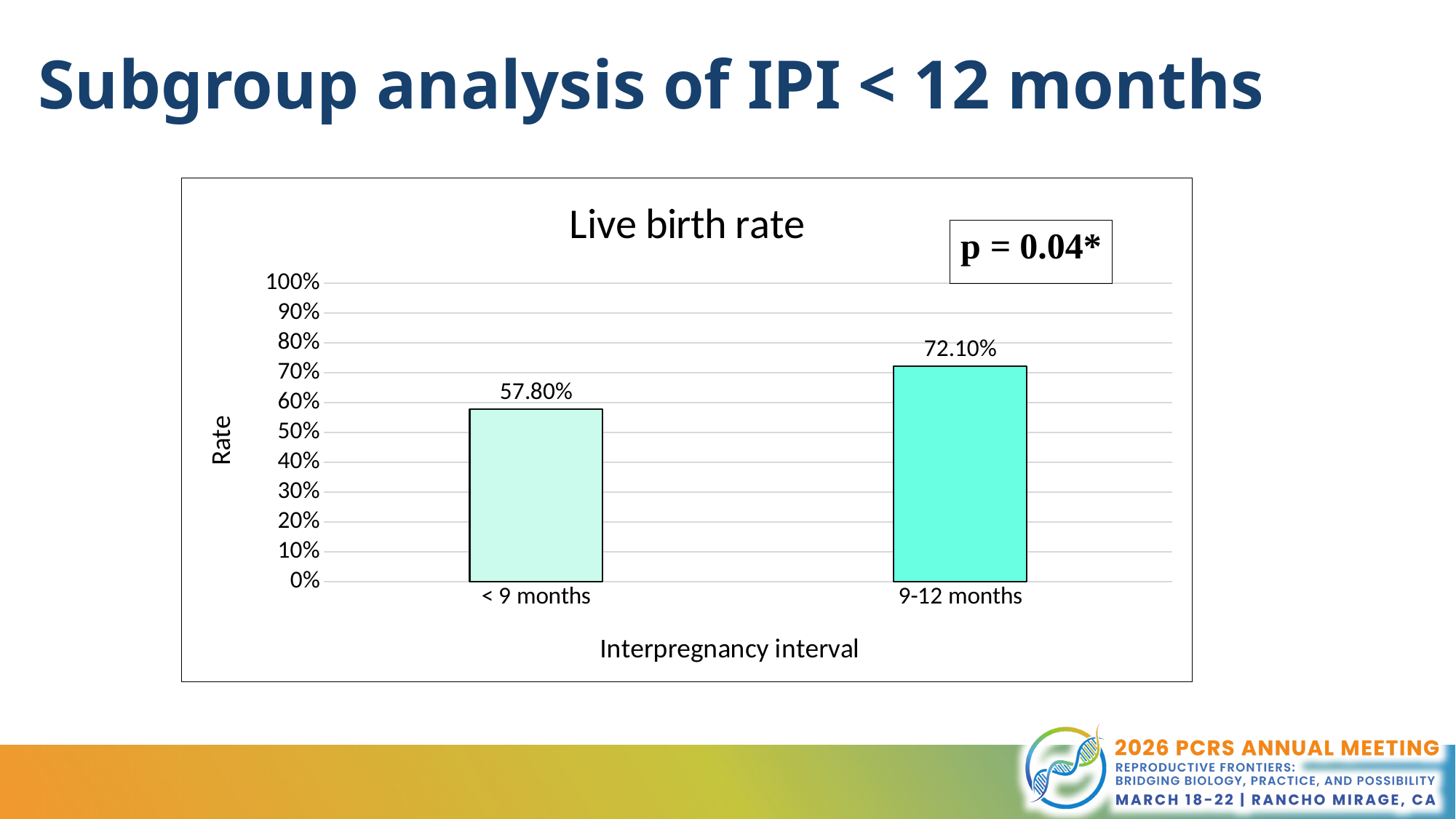
What p-value is shown on the chart? p = 0.04* Which interpregnancy interval has the lower live birth rate? < 9 months Do the live birth rate values rise or fall from < 9 months to 9-12 months? rise Which interpregnancy interval has the higher live birth rate? 9-12 months What is the difference in live birth rate between the 9-12 months and < 9 months groups? 14.30% How many interpregnancy interval categories are shown in the chart? 2 Is the live birth rate for < 9 months greater or less than 60%? less Is the live birth rate for 9-12 months greater or less than 70%? greater What is the live birth rate for the 9-12 months interpregnancy interval? 72.10% What is the title of the chart? Live birth rate What type of chart is used to show the live birth rate? bar chart What is the live birth rate for the < 9 months interpregnancy interval? 57.80%